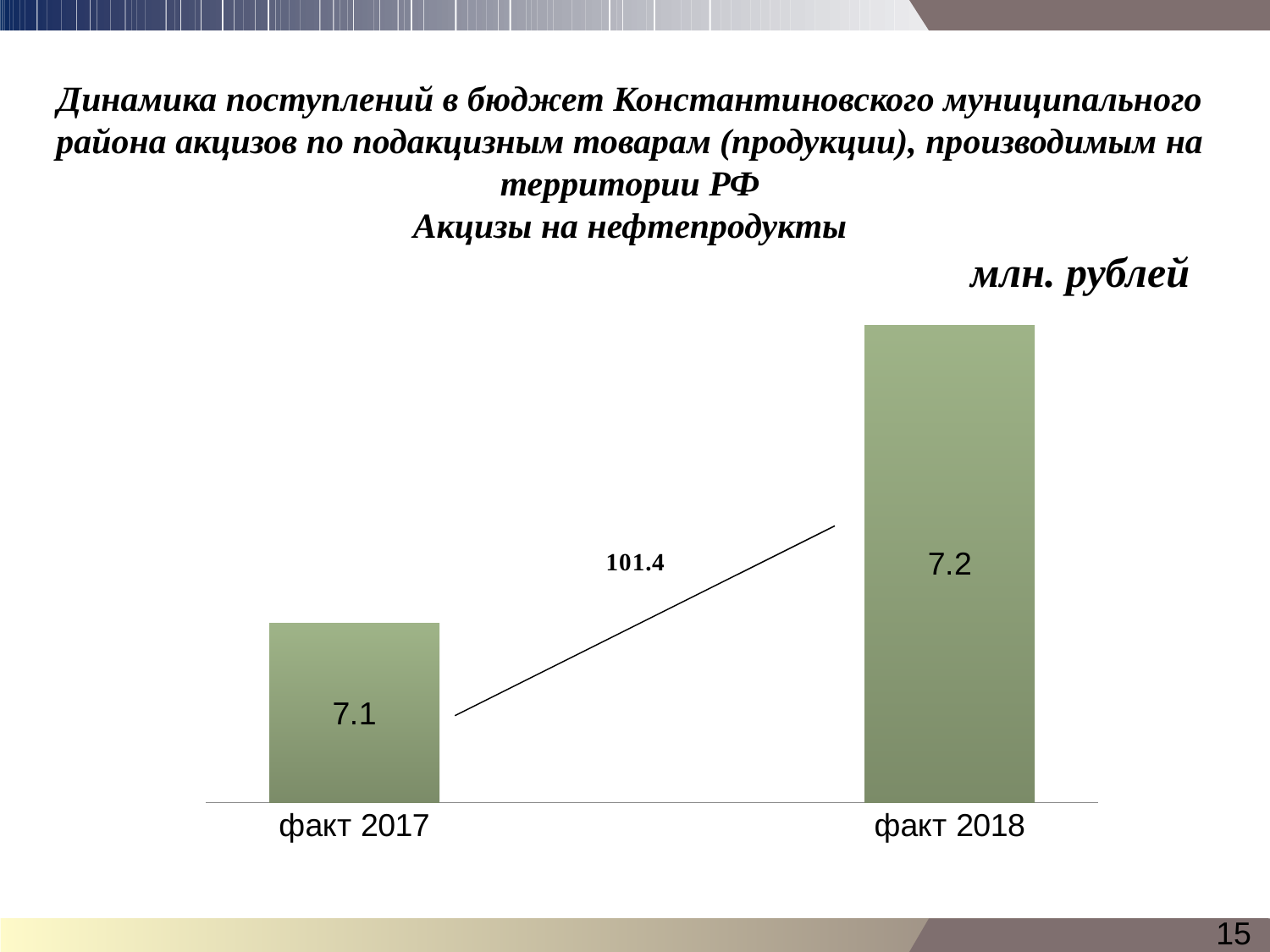
Which category has the highest value? факт 2018 How many categories are shown on the chart? 2 Which category has the lowest value? факт 2017 What unit of measurement is indicated above the chart? млн. рублей What is the difference between the values for факт 2018 and факт 2017? 0.1 Do the values rise or fall from факт 2017 to факт 2018? rise What percentage figure is printed on the line connecting the two bars? 101.4 What is the value for факт 2017? 7.1 What kind of chart is shown on the slide? bar chart What is the value for факт 2018? 7.2 Which is larger, the value for факт 2017 or факт 2018? факт 2018